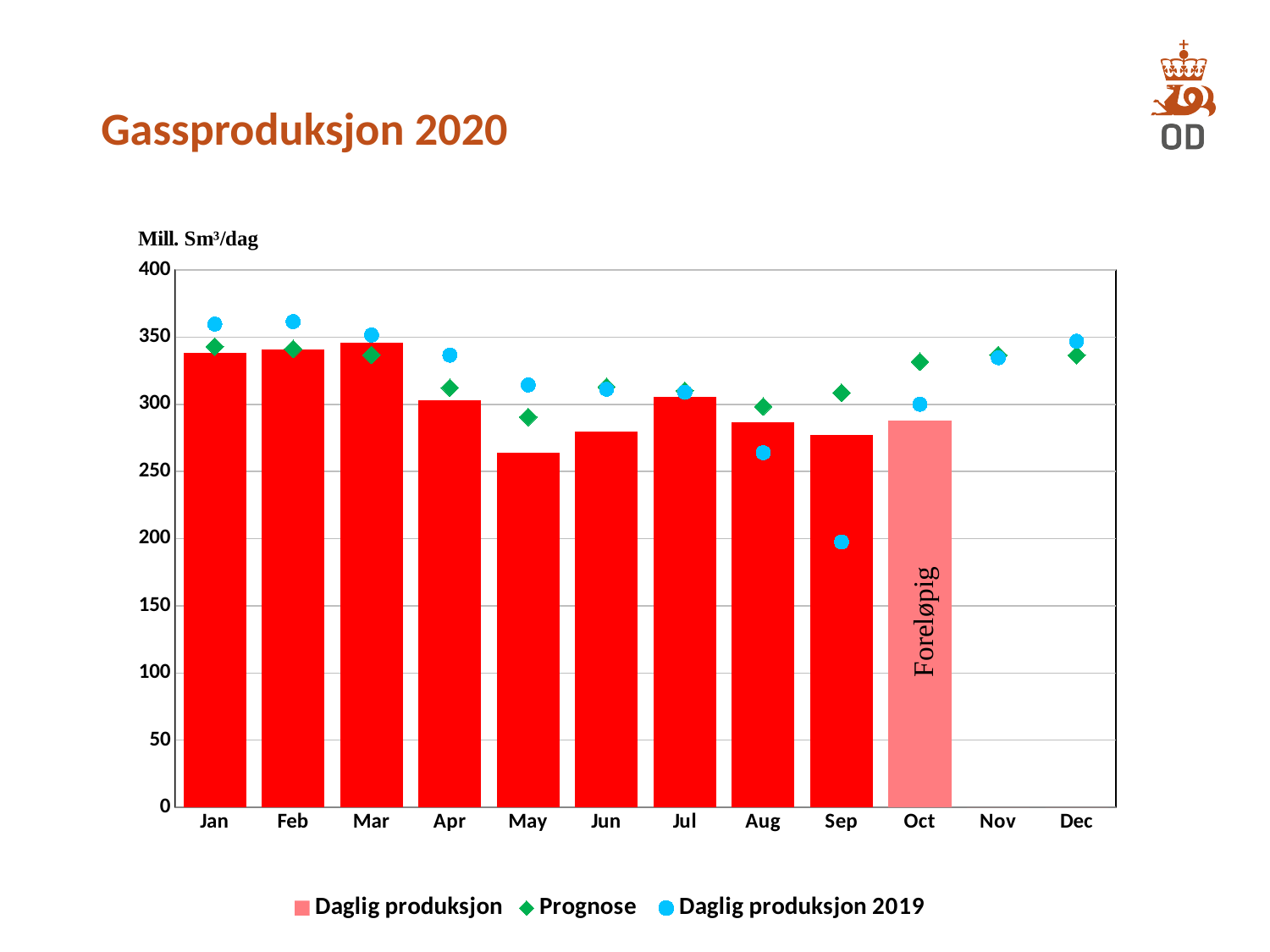
Do the Daglig produksjon bars rise or fall from Jan to May? They rise slightly from Jan to Mar, then fall to May How many months are shown on the x axis? 12 What kind of chart is shown on the slide? Bar chart (with point markers) Is the Daglig produksjon value for Jan greater or less than 300? greater What unit is shown above the y axis? Mill. Sm³/dag How many months have a Daglig produksjon bar plotted? 10 Which month has the highest Daglig produksjon bar? Mar Which is larger in Sep: the Daglig produksjon bar or the Daglig produksjon 2019 point? Daglig produksjon bar Is the Daglig produksjon 2019 value for Sep greater or less than 250? less Which month has the lowest Daglig produksjon bar? May How many series does the legend list? 3 Is the Prognose value for Dec greater or less than 300? greater